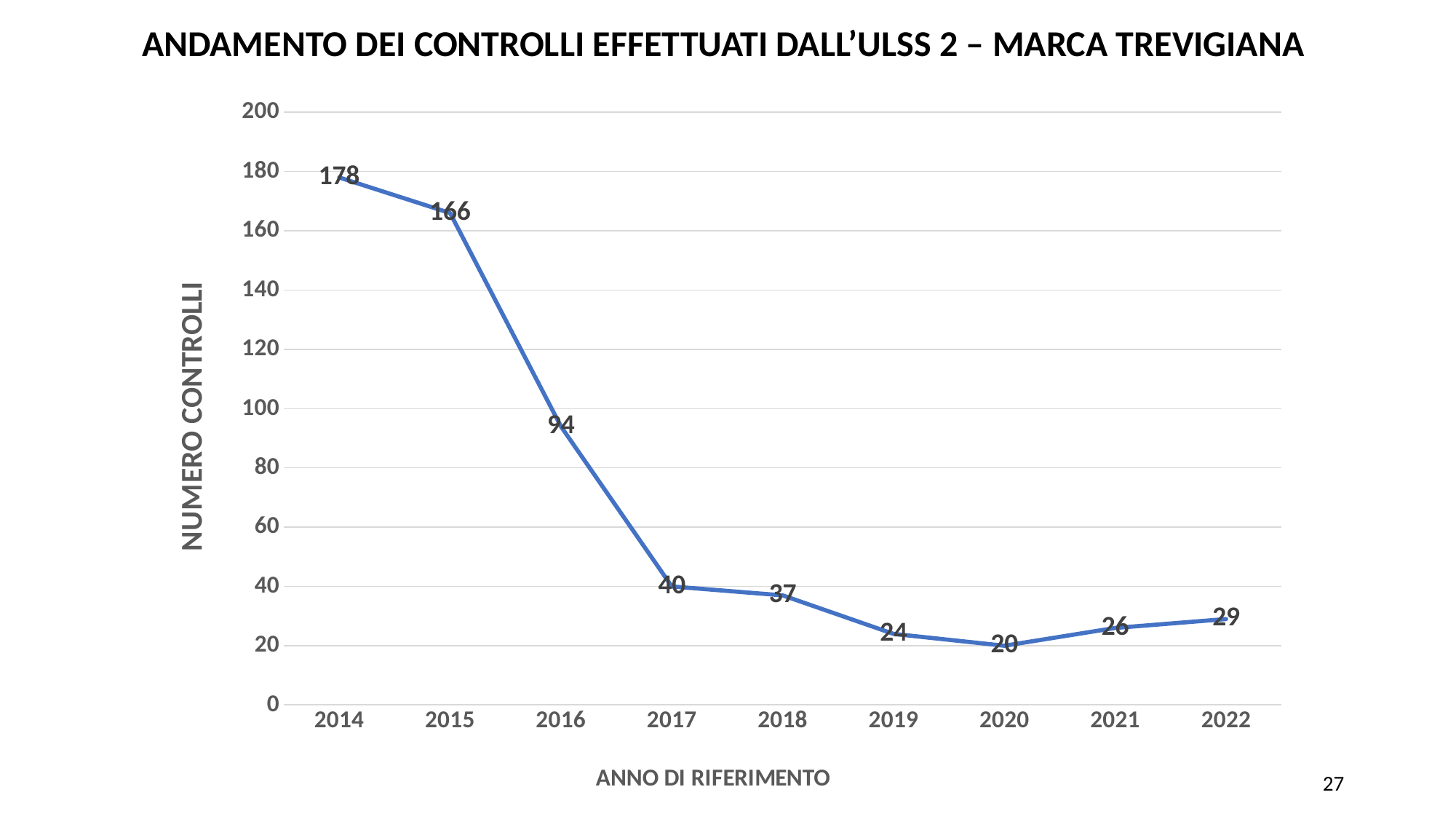
What kind of chart is this? line chart What is the number of controls in 2022? 29 Which year has the lowest number of controls? 2020 What is the number of controls in 2016? 94 Which year has more controls, 2017 or 2018? 2017 Which year has the highest number of controls? 2014 What is the label of the y axis? NUMERO CONTROLLI What is the number of controls in 2014? 178 What is the difference between the number of controls in 2014 and 2022? 149 What is the difference between the number of controls in 2015 and 2016? 72 How many years are shown on the x axis? 9 Is the value for 2016 greater or less than 100? less